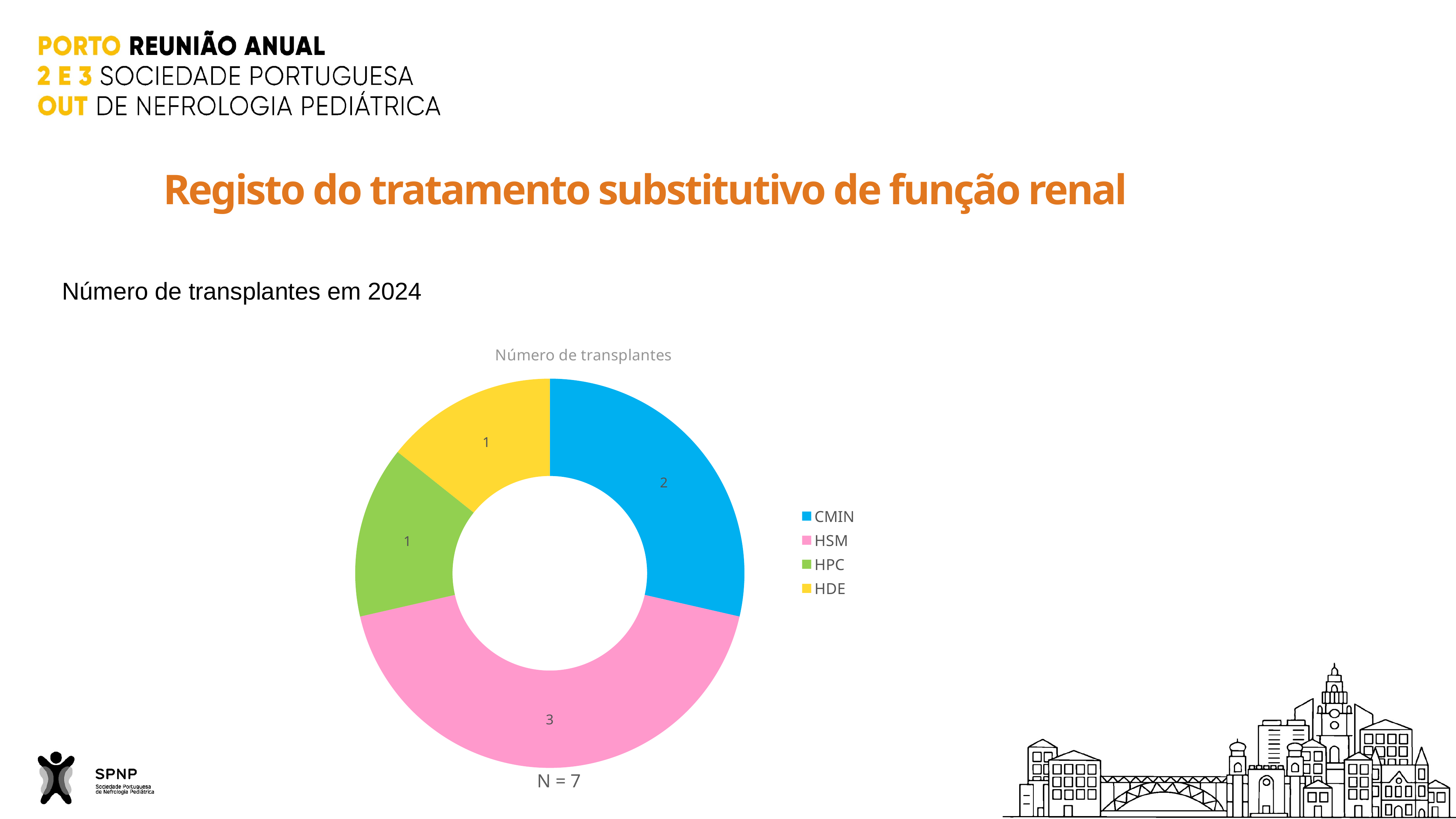
What is the number of transplants for HDE? 1 What is the difference between the number of transplants for HSM and CMIN? 1 What kind of chart is shown on the slide? Doughnut chart Which has more transplants, CMIN or HPC? CMIN What is the total number of transplants shown in the chart? 7 Which centre has the highest number of transplants? HSM What is the number of transplants for CMIN? 2 What is the number of transplants for HPC? 1 How many centres are shown in the chart? 4 What is the number of transplants for HSM? 3 What colour represents HSM in the chart? Pink What is the title of the chart? Número de transplantes